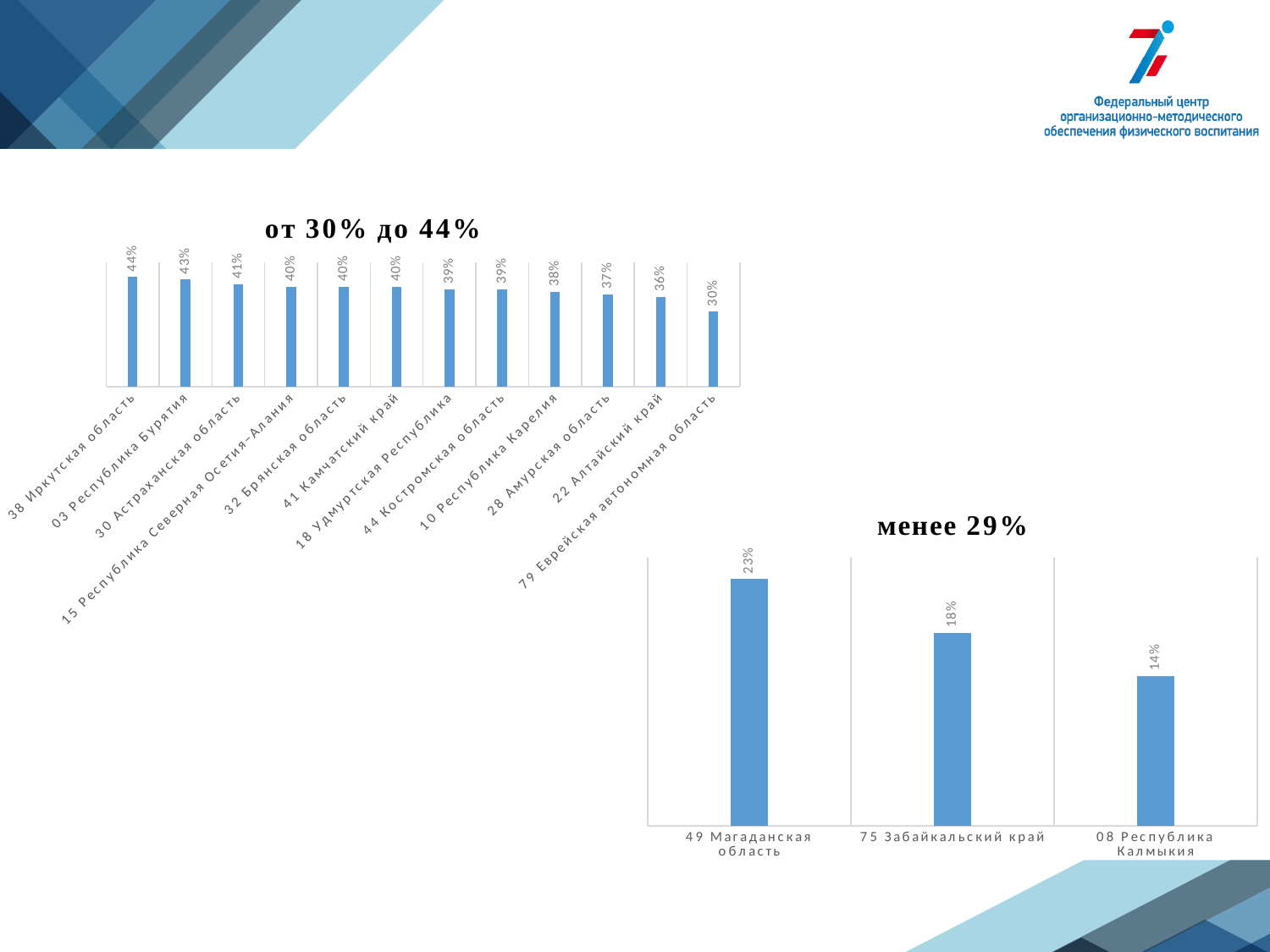
In the chart titled "от 30% до 44%", which category has the highest value? 38 Иркутская область In the chart titled "менее 29%", which category has the lowest value? 08 Республика Калмыкия In the chart titled "от 30% до 44%", what is the value for 38 Иркутская область? 44% In the chart titled "менее 29%", how many categories are plotted? 3 In the chart titled "от 30% до 44%", what is the value for 79 Еврейская автономная область? 30% In the chart titled "менее 29%", which category has the highest value? 49 Магаданская область In the chart titled "менее 29%", what is the value for 75 Забайкальский край? 18% What kind of chart is the one titled "менее 29%"? Bar chart In the chart titled "от 30% до 44%", what is the difference between the values for 03 Республика Бурятия and 22 Алтайский край? 7% In the chart titled "от 30% до 44%", how many categories are plotted? 12 In the chart titled "менее 29%", what is the difference between the values for 49 Магаданская область and 08 Республика Калмыкия? 9% In the chart titled "от 30% до 44%", which category has the lowest value? 79 Еврейская автономная область